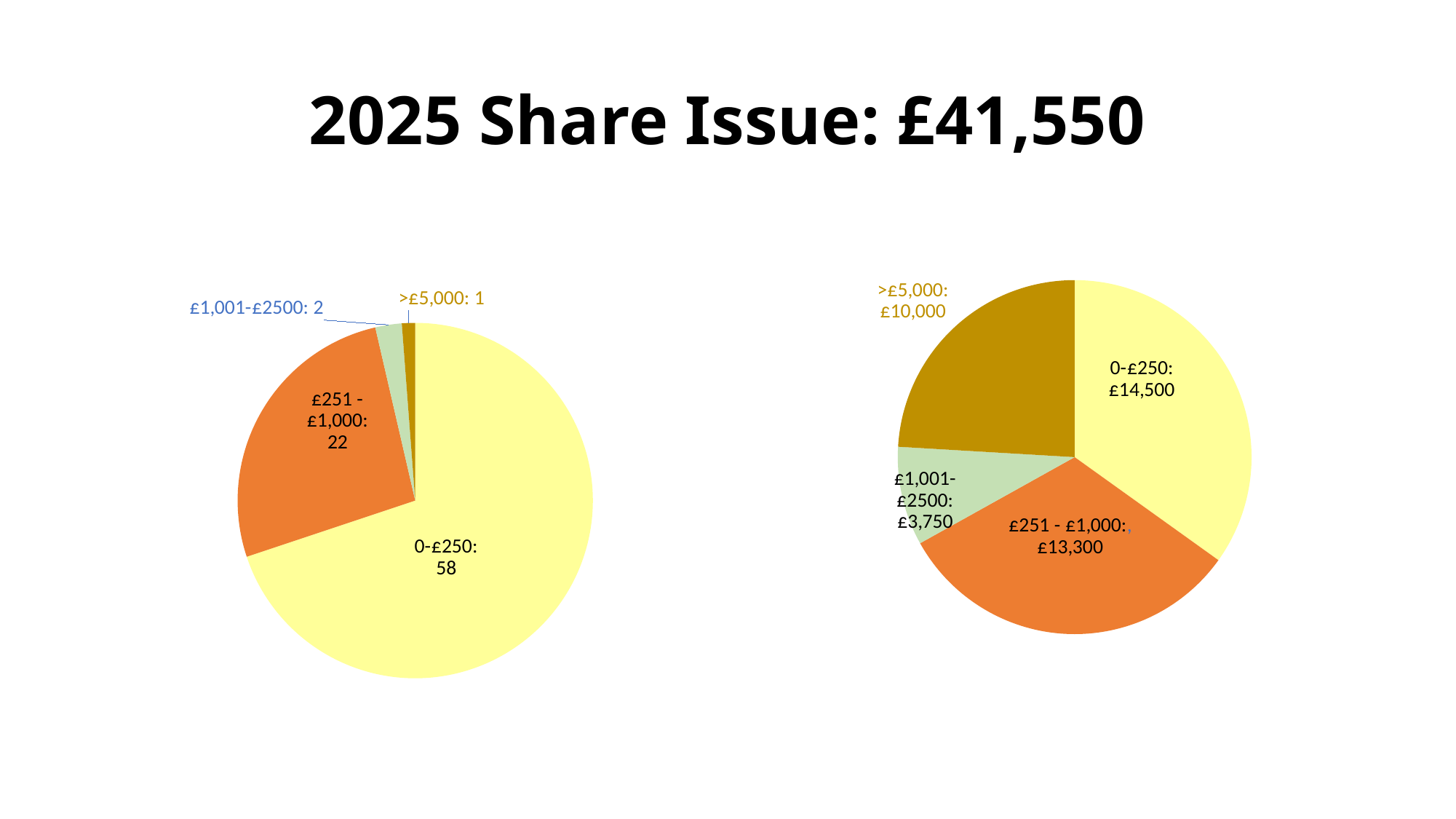
In the left pie chart, what is the value for the £251 - £1,000 slice? 22 In the left pie chart, which category has the smallest value? >£5,000 In the left pie chart, what is the difference between the 0-£250 value and the £251 - £1,000 value? 36 In the right pie chart, which category has the largest amount? 0-£250 What type of chart is shown on the right of the slide? Pie chart In the right pie chart, what amount is shown for the £1,001-£2500 slice? £3,750 In the left pie chart, how many shareholders are in the 0-£250 category? 58 In the right pie chart, what amount is shown for the >£5,000 slice? £10,000 How many slices does the left pie chart have? 4 In the right pie chart, which is larger: the >£5,000 slice or the £1,001-£2500 slice? >£5,000 In the right pie chart, what is the difference between the 0-£250 amount and the £251 - £1,000 amount? £1,200 In the right pie chart, which category has the smallest amount? £1,001-£2500